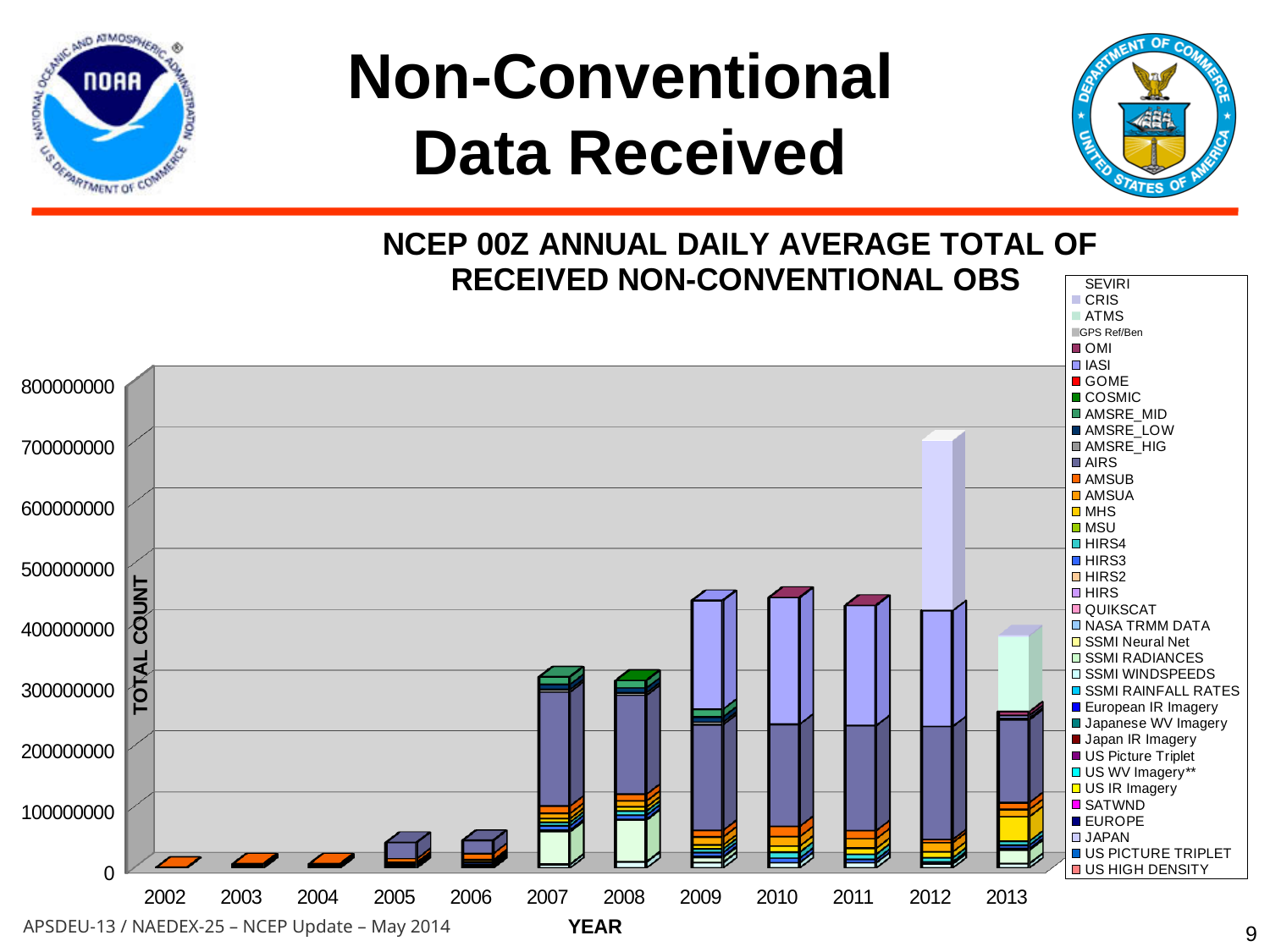
Which year has the lowest total count in the chart? 2002 Which year has a larger total count, 2011 or 2012? 2012 What kind of chart is shown on the slide? Stacked bar chart How many years are shown on the x axis of the chart? 12 Which year has a larger total count, 2009 or 2013? 2009 Is the total count for 2010 greater or less than 400000000? greater Is the total count for 2009 greater or less than 400000000? greater What is the label on the vertical axis of the chart? TOTAL COUNT Is the total count for 2005 greater or less than 100000000? less Does the total count generally rise or fall from 2002 to 2012? rise Which year has the highest total count in the chart? 2012